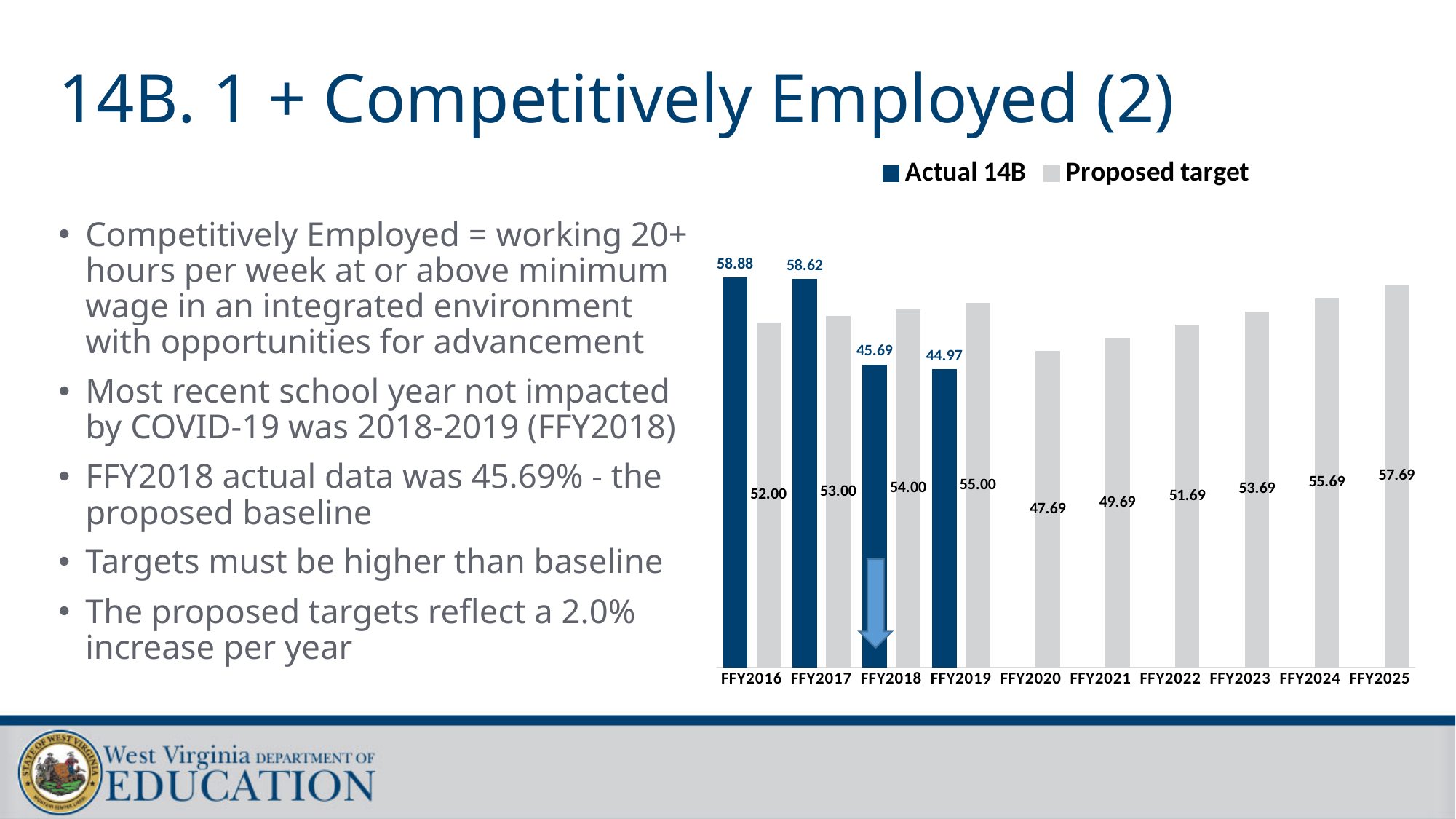
What is the Proposed target value for FFY2025? 57.69 How many series does the legend list? 2 What is the difference between the Actual 14B value for FFY2017 and the Actual 14B value for FFY2018? 12.93 What is the Actual 14B value for FFY2019? 44.97 What is the Proposed target value for FFY2020? 47.69 Do the Proposed target values rise or fall from FFY2020 to FFY2025? Rise Which year has the lowest Proposed target value? FFY2020 Which year has the highest Actual 14B value? FFY2016 What kind of chart is shown on the slide? Bar chart What is the Actual 14B value for FFY2016? 58.88 Which is larger for FFY2019: the Actual 14B value or the Proposed target value? Proposed target How many years are shown on the x axis? 10